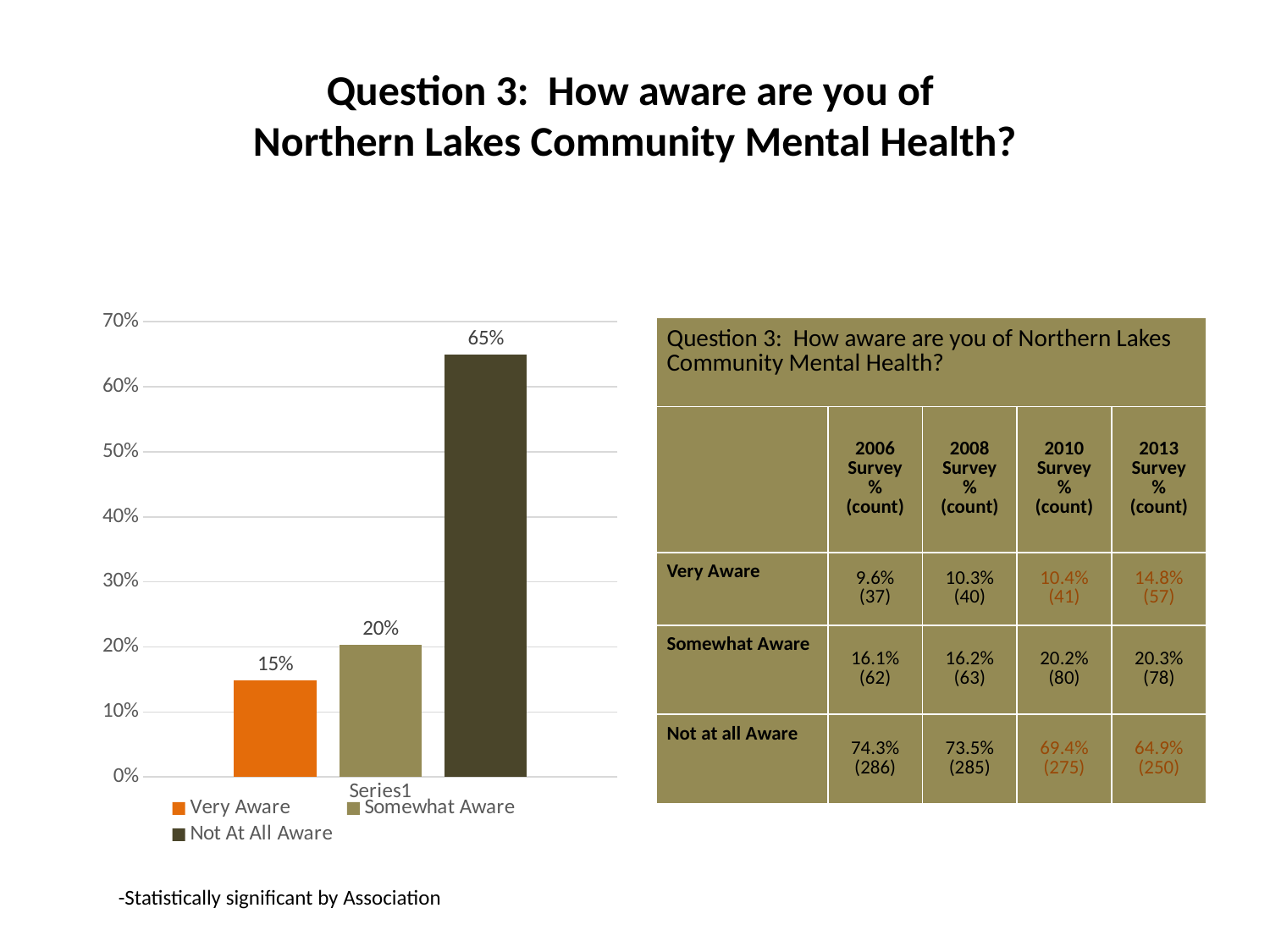
Which series has the lowest value in the bar chart? Very Aware Which is larger in the bar chart, Very Aware or Somewhat Aware? Somewhat Aware What value is shown for Very Aware in the bar chart? 15% What is the difference between the Somewhat Aware value and the Very Aware value in the bar chart? 5% What colour is the Very Aware bar in the chart? orange What value is shown for Somewhat Aware in the bar chart? 20% What is the difference between the Not At All Aware value and the Somewhat Aware value in the bar chart? 45% How many series does the legend of the bar chart list? 3 Is the value for Not At All Aware greater or less than 60%? greater What kind of chart is shown on the slide? bar chart Which series has the highest value in the bar chart? Not At All Aware What value is shown for Not At All Aware in the bar chart? 65%